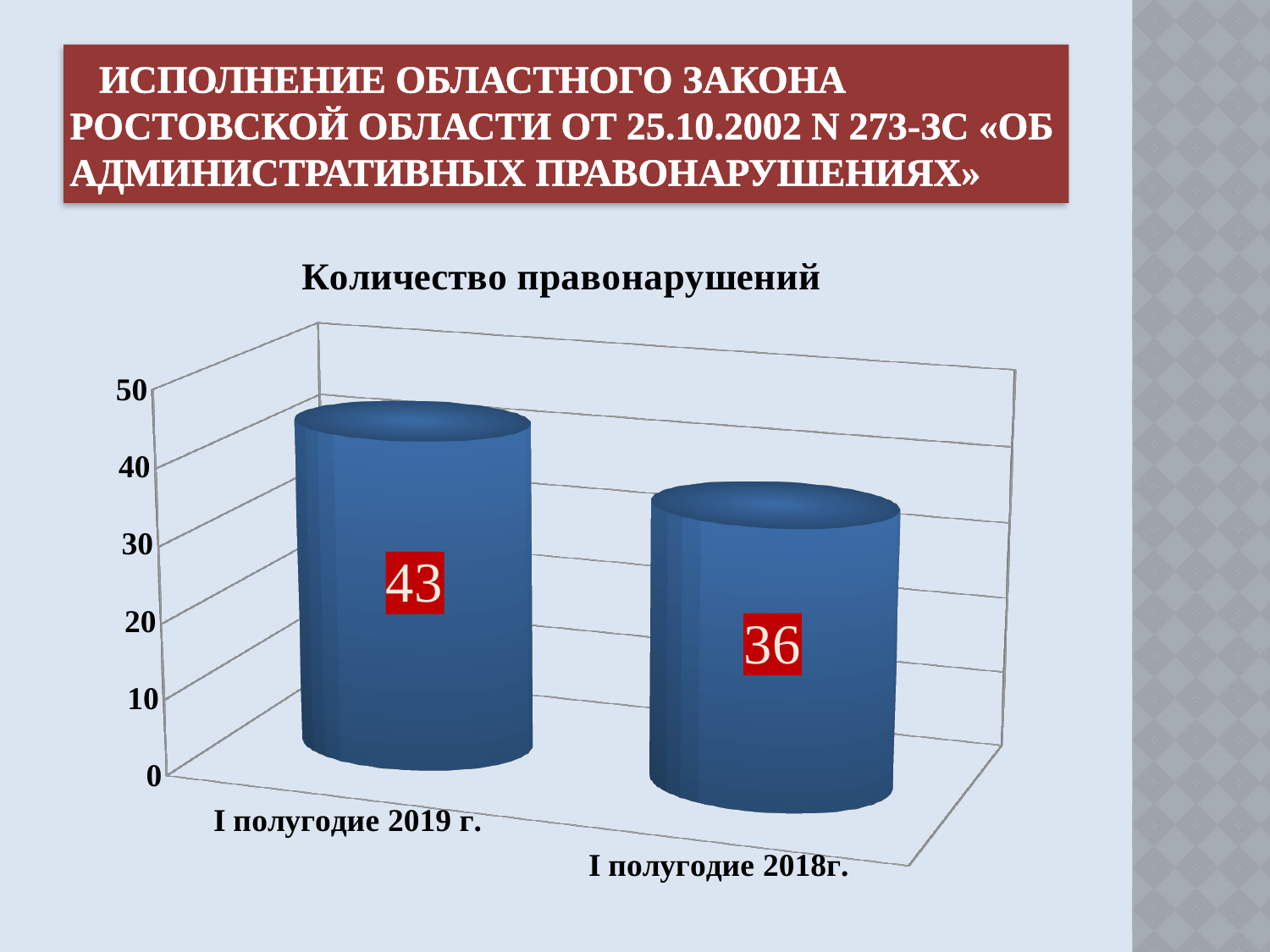
Is the value for I полугодие 2019 г. greater or less than 40? greater What kind of chart is shown on the slide? bar chart What is the difference between the values for I полугодие 2019 г. and I полугодие 2018г.? 7 How many categories are shown in the chart? 2 Which is larger: the value for I полугодие 2019 г. or for I полугодие 2018г.? I полугодие 2019 г. What is the title of the chart? Количество правонарушений What is the value for I полугодие 2019 г.? 43 Which category has the highest value? I полугодие 2019 г. What is the value for I полугодие 2018г.? 36 What is the highest value shown on the vertical axis? 50 Is the value for I полугодие 2018г. greater or less than 40? less Which category has the lowest value? I полугодие 2018г.